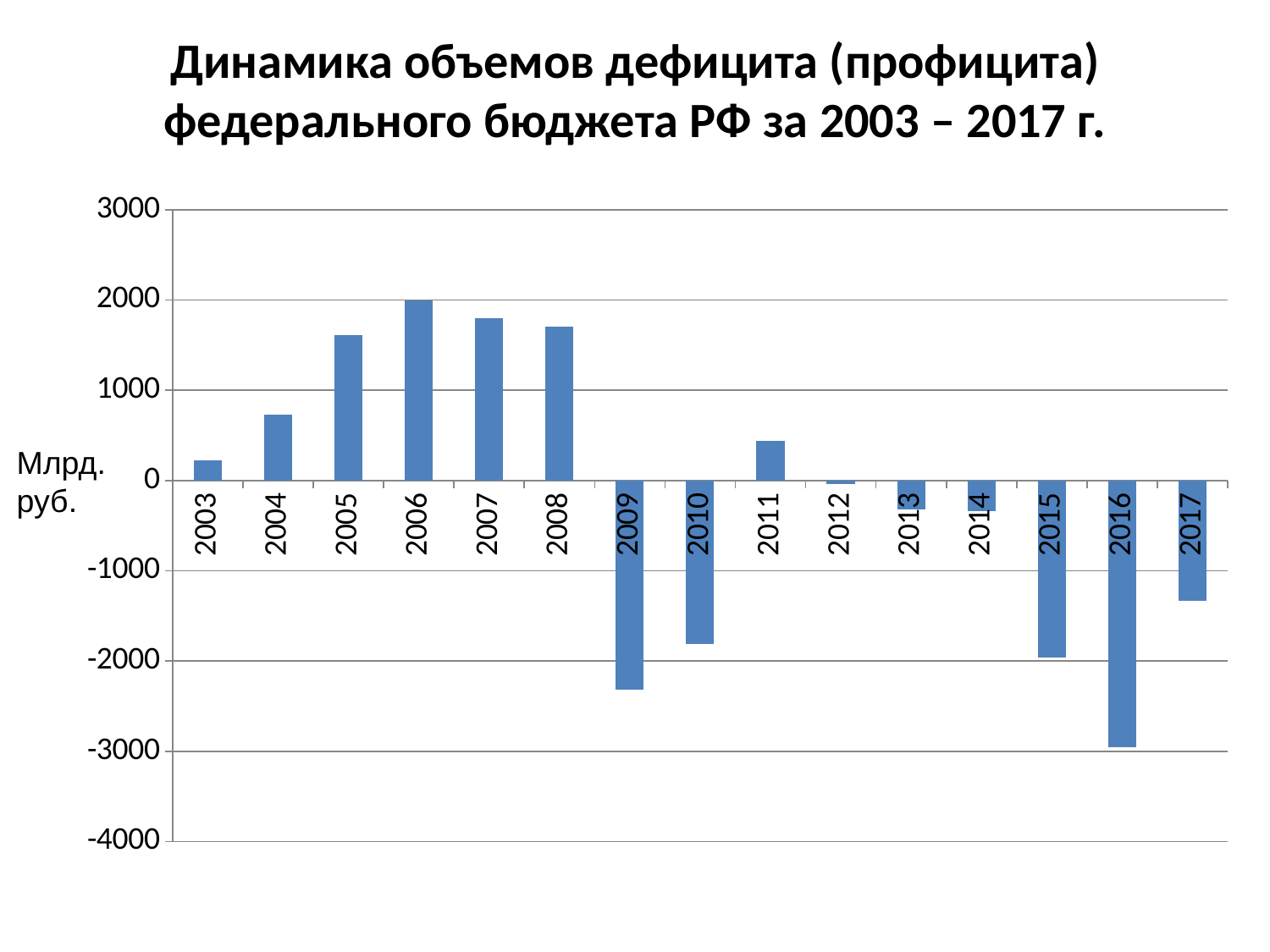
What kind of chart is shown on the slide? Bar chart Is the value for 2005 greater or less than 1000? greater What unit is shown on the vertical axis label? Млрд. руб. Is the value for 2009 greater or less than -2000? less Which year has the larger value, 2009 or 2010? 2010 How many years are plotted on the chart? 15 Which year has the highest value on the chart? 2006 Which year has the lowest value on the chart? 2016 Is the value for 2004 greater or less than 1000? less Do the values rise or fall from 2003 to 2006? Rise Which year has the larger value, 2005 or 2007? 2007